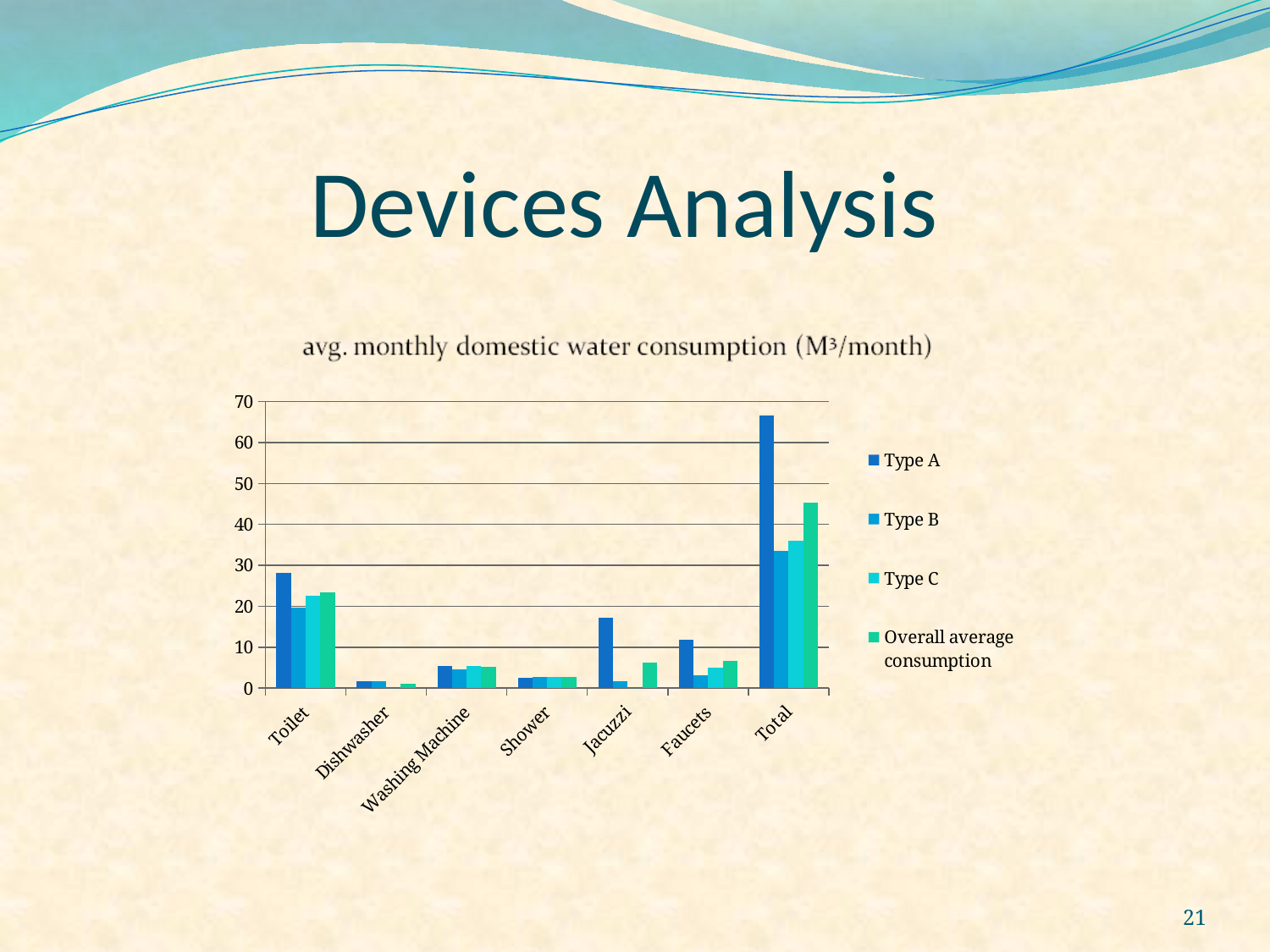
Is the Type B value for Total greater or less than 40? less What is the title of the chart? avg. monthly domestic water consumption (M³/month) What kind of chart is shown on the slide? bar chart For Jacuzzi, which is larger: Type A or Type B? Type A How many categories are shown on the x axis? 7 Which category has the highest Type A value? Total For Faucets, which is larger: Type A or Type C? Type A Is the Type A value for Toilet greater or less than 20? greater Is the Overall average consumption value for Total greater or less than 40? greater How many series does the legend list? 4 Which category has the highest Overall average consumption value? Total